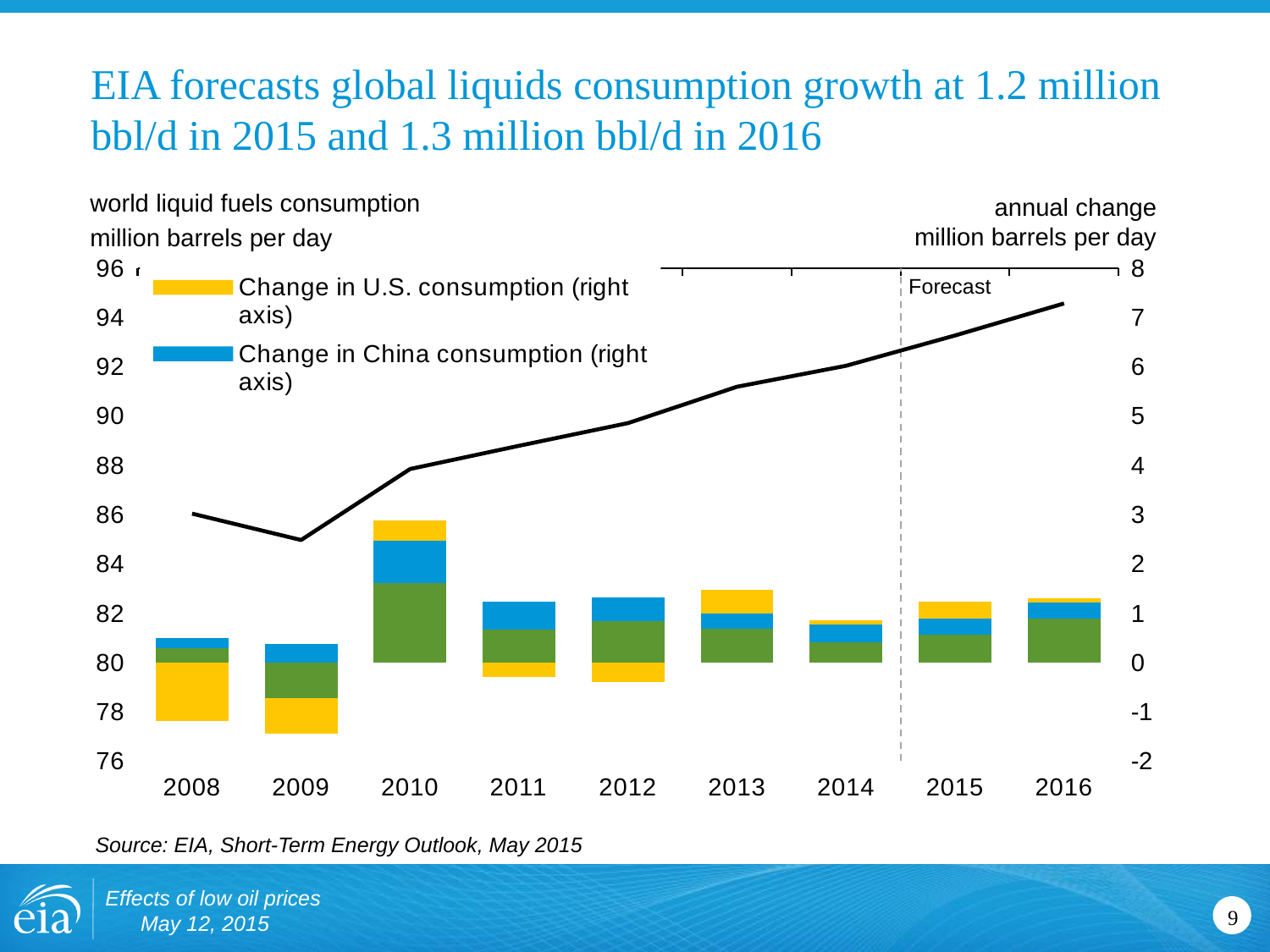
What is the unit shown for the left axis of the chart? million barrels per day Does the world liquid fuels consumption line rise or fall from 2009 to 2016? Rises Which is larger, the total annual change in consumption for 2010 or for 2011? 2010 Is the world liquid fuels consumption value for 2009 greater or less than 86 million barrels per day? less What kind of chart is shown on the slide? A combination chart with a line and stacked bars Which years on the chart are marked as forecast? 2015 and 2016 How many series does the chart's legend list? 2 Is the world liquid fuels consumption value for 2013 greater or less than 90 million barrels per day? greater Is the change in U.S. consumption for 2008 greater or less than 0? less How many years are shown along the x axis of the chart? 9 Which year shows the largest total annual change in consumption (tallest stacked bar)? 2010